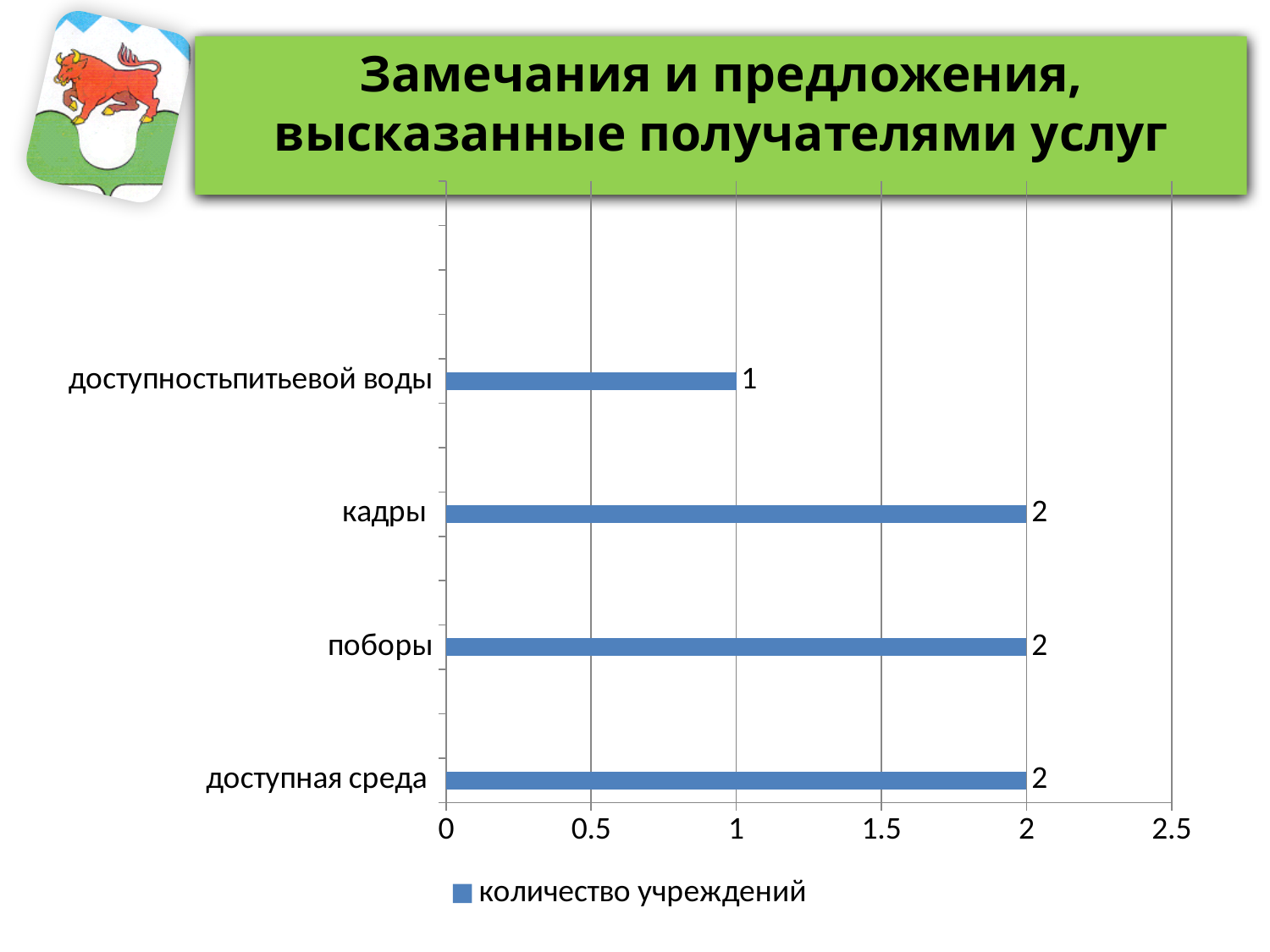
Which is larger, the value for поборы or the value for доступность питьевой воды? поборы Which category has the lowest value? доступность питьевой воды Is the value for доступная среда greater or less than 1.5? greater How many series does the legend list? 1 How many categories are shown in the chart? 4 What is the value for доступная среда? 2 What is the value for кадры? 2 What kind of chart is shown on the slide? bar chart What is the name of the series in the legend? количество учреждений What is the value for доступность питьевой воды? 1 What is the value for поборы? 2 What is the difference between the values for кадры and доступность питьевой воды? 1